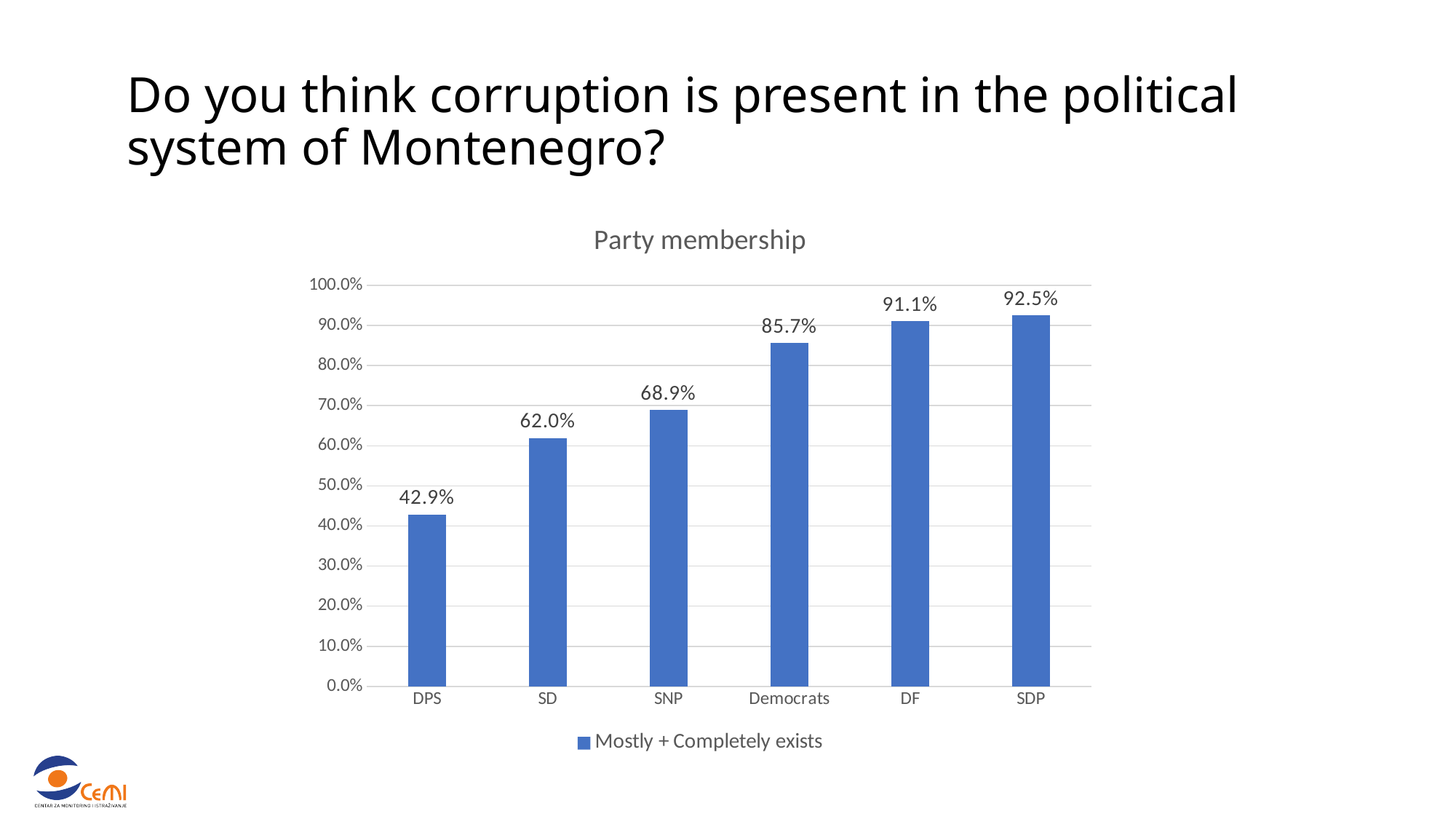
What is the difference between the values for DF and SD? 29.1% Which is larger, the value for SD or the value for SNP? SNP What kind of chart is shown? bar chart What is the value for Democrats? 85.7% Is the value for Democrats greater or less than 80.0%? greater What is the value for SNP? 68.9% What is the title of the chart? Party membership What is the value for DPS? 42.9% What is the difference between the values for SDP and DPS? 49.6% Which party has the lowest value? DPS How many parties are shown on the x axis? 6 Which party has the highest value? SDP